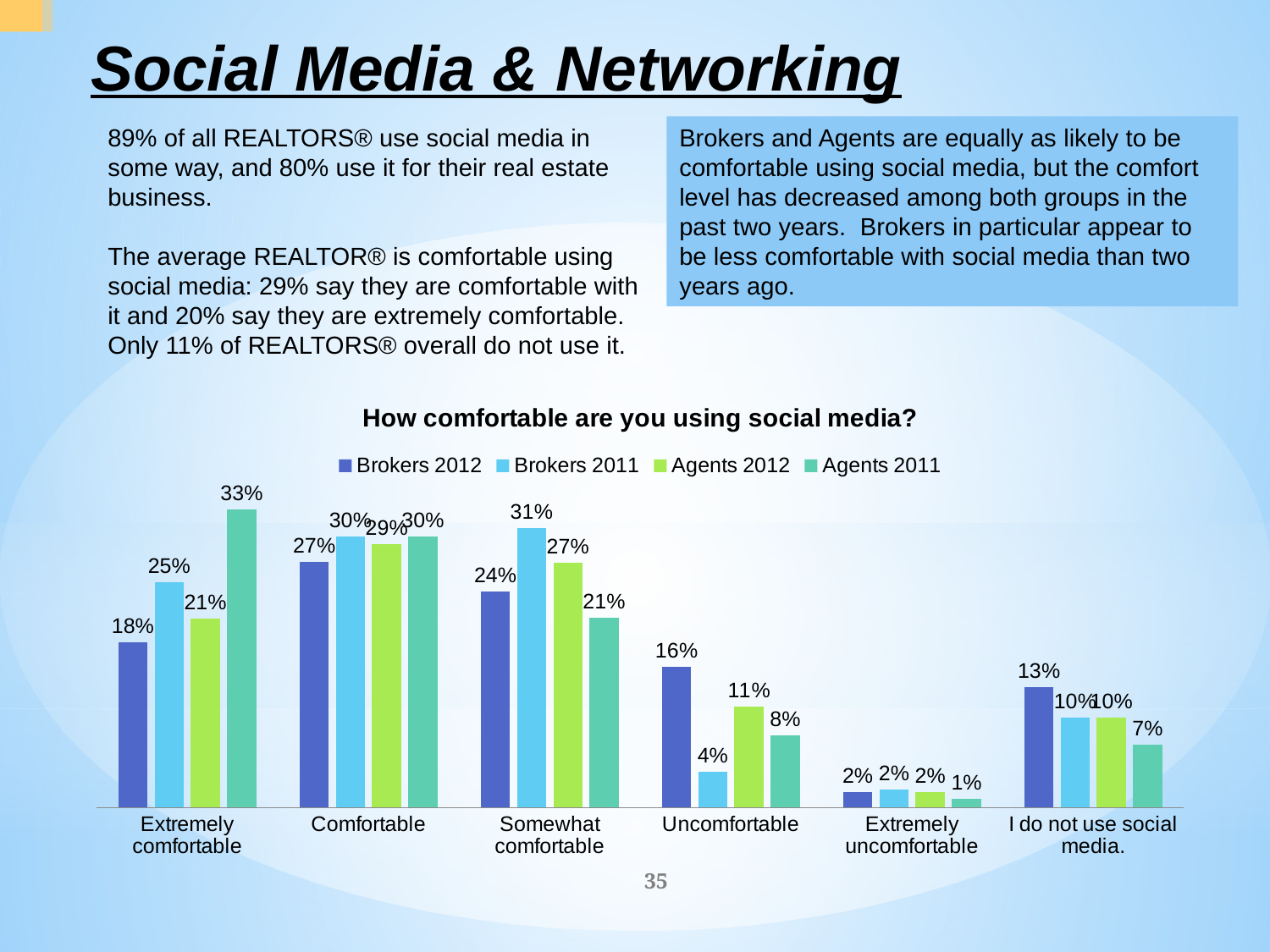
What is the title of the chart? How comfortable are you using social media? Which series has the lowest value in the Uncomfortable category? Brokers 2011 What is the value for Brokers 2012 in the Extremely comfortable category? 18% How many series does the legend list? 4 What is the value for Agents 2012 in the Uncomfortable category? 11% What is the difference between Brokers 2012 and Brokers 2011 in the Uncomfortable category? 12% What kind of chart is shown on the slide? Bar chart Which series has the highest value in the Extremely comfortable category? Agents 2011 What is the value for Agents 2011 in the Extremely comfortable category? 33% What is the value for Brokers 2011 in the Somewhat comfortable category? 31% How many categories are shown on the x axis? 6 Which is larger in the Somewhat comfortable category: Brokers 2012 or Agents 2012? Agents 2012